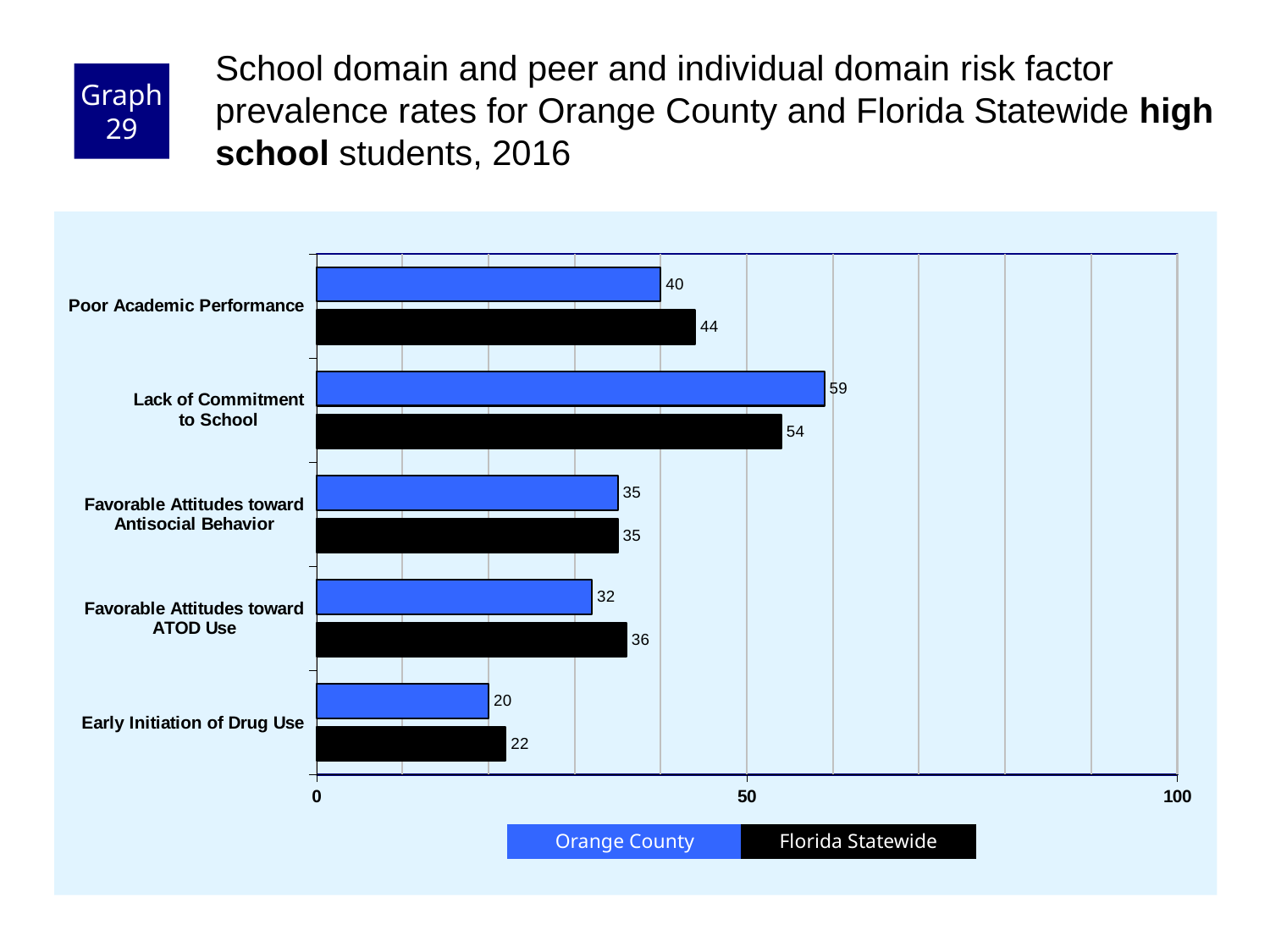
What is the Florida Statewide value for Poor Academic Performance? 44 How many risk factor categories are shown on the chart? 5 What is the difference between the Florida Statewide and Orange County values for Favorable Attitudes toward ATOD Use? 4 Is the Orange County value for Lack of Commitment to School greater or less than 50? greater For Lack of Commitment to School, which is larger: the Orange County value or the Florida Statewide value? Orange County Which risk factor has the lowest Florida Statewide value? Early Initiation of Drug Use Which colour represents Florida Statewide in the legend? black Which risk factor has the highest Orange County value? Lack of Commitment to School What is the Orange County value for Early Initiation of Drug Use? 20 What is the Orange County value for Lack of Commitment to School? 59 How many series does the legend list? 2 What kind of chart is shown on the slide? bar chart